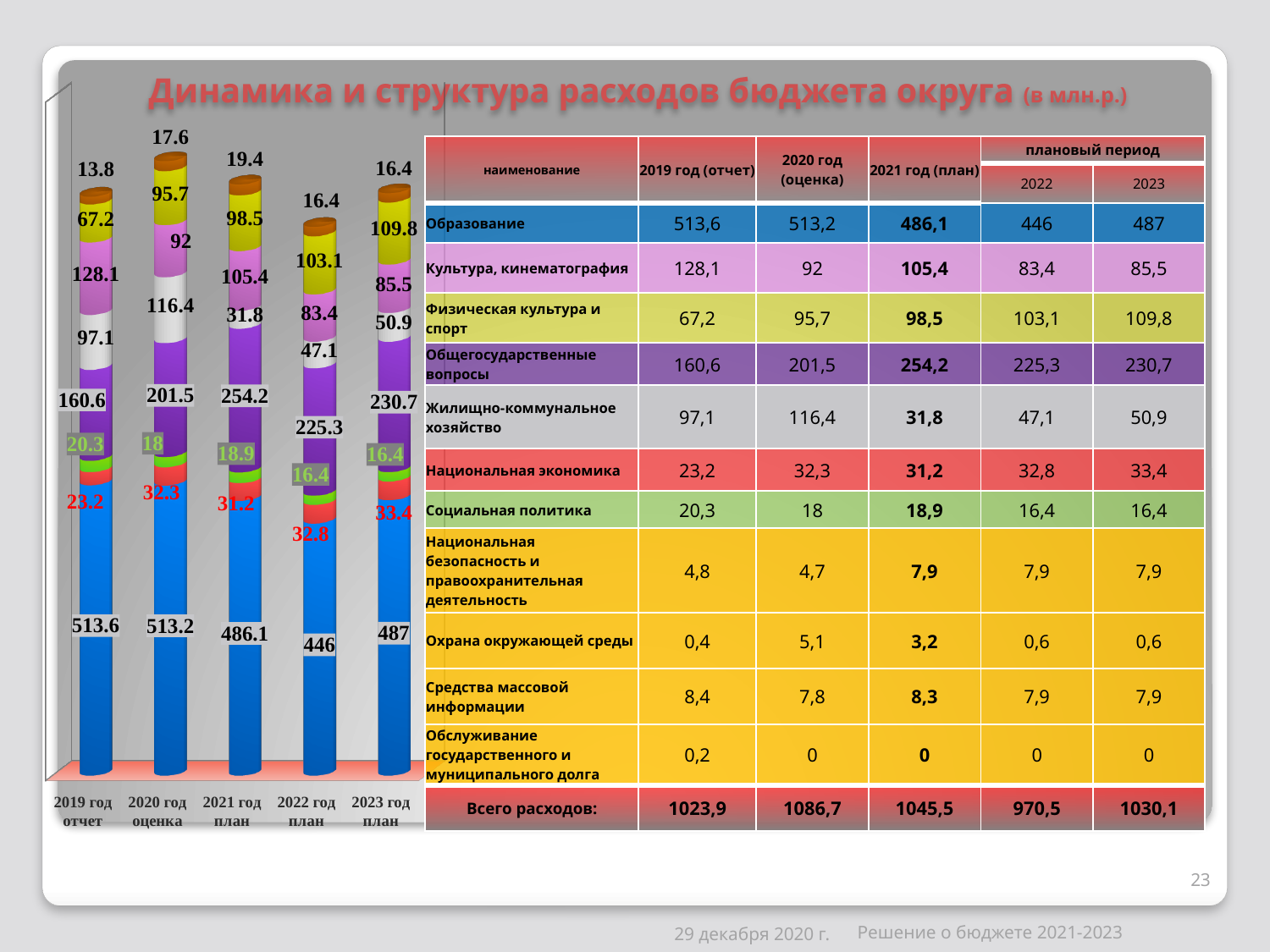
Which is larger: the purple segment for 2021 год план or for 2020 год оценка? 2021 год план What is the value of the white segment of the bar for 2020 год оценка? 116.4 What is the value printed at the top of the bar for 2020 год оценка? 17.6 What is the value of the blue (bottom) segment of the bar for 2019 год отчет? 513.6 What kind of chart is shown on the left of the slide? stacked bar chart How many bars (years) does the chart show? 5 Which year has the lowest value for the blue (bottom) segment? 2022 год план Which year has the highest value for the blue (bottom) segment? 2019 год отчет What is the difference between the blue segment values for 2019 год отчет and 2022 год план? 67.6 What is the value of the blue (bottom) segment of the bar for 2022 год план? 446 What is the title of the slide's chart? Динамика и структура расходов бюджета округа (в млн.р.) Do the purple segment values rise or fall from 2019 год отчет to 2021 год план? rise